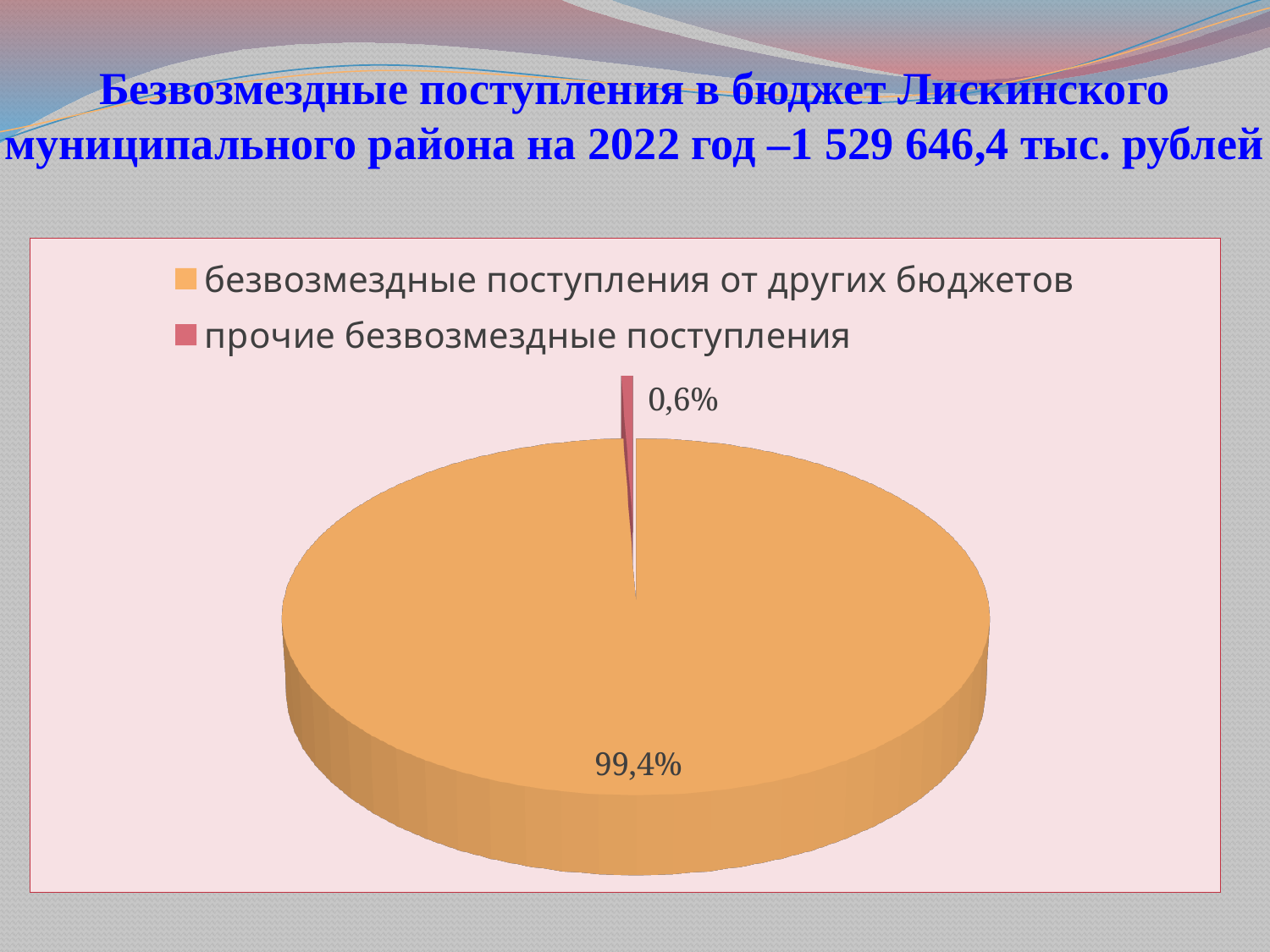
Which category has the largest slice of the pie? безвозмездные поступления от других бюджетов What kind of chart is shown on the slide? pie chart What share of the pie does 'безвозмездные поступления от других бюджетов' take? 99,4% What total amount in thousand rubles is stated in the slide title? 1 529 646,4 тыс. рублей Which is larger: the slice for 'безвозмездные поступления от других бюджетов' or the slice for 'прочие безвозмездные поступления'? безвозмездные поступления от других бюджетов How many slices does the pie chart have? 2 What share of the pie does 'прочие безвозмездные поступления' take? 0,6% How many entries does the legend list? 2 Which category has the smallest slice of the pie? прочие безвозмездные поступления What is the difference in percentage points between the two slices? 98,8 What colour is the slice for 'прочие безвозмездные поступления'? red